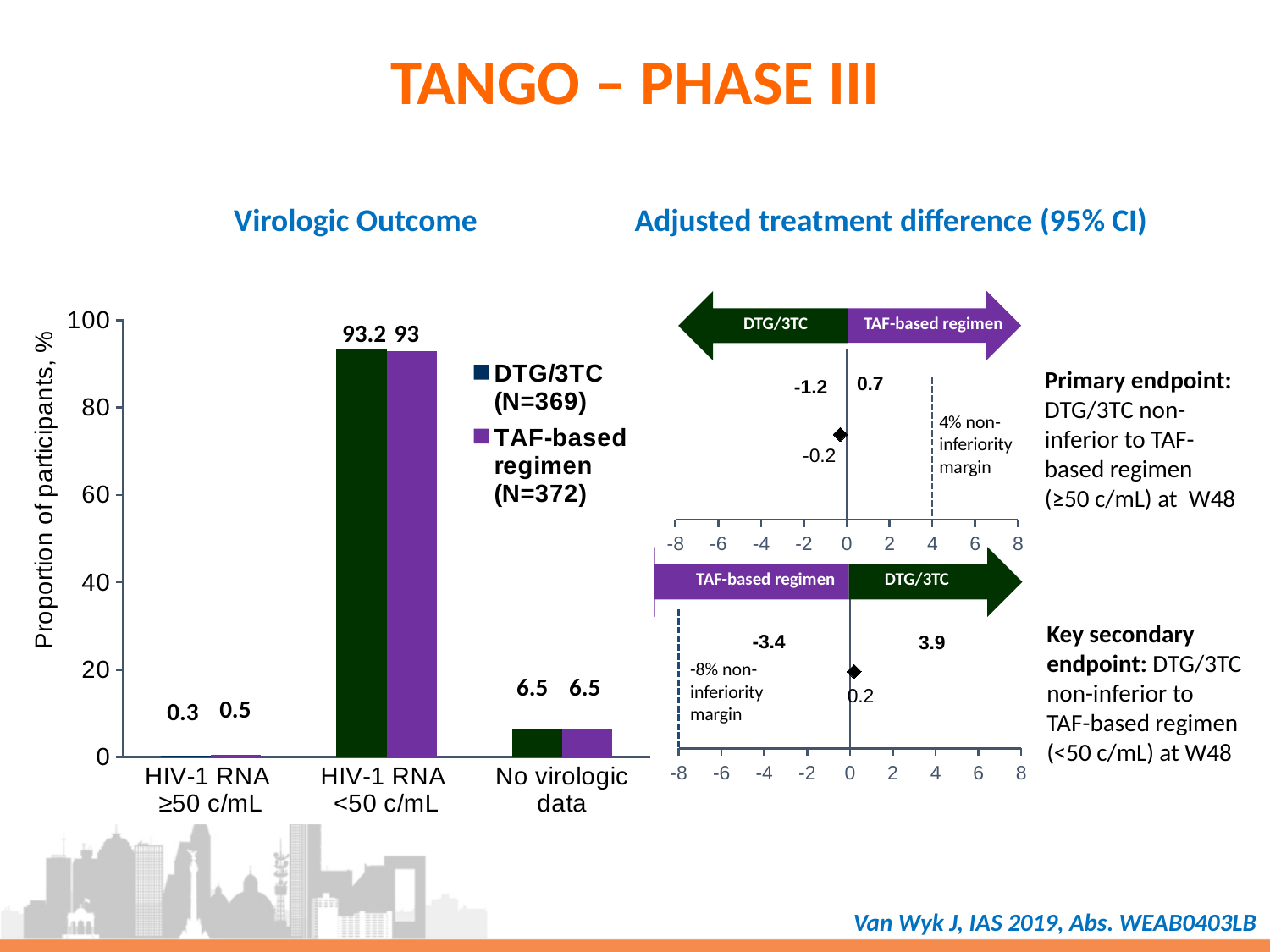
In the Virologic Outcome chart, which is larger in the HIV-1 RNA ≥50 c/mL category: DTG/3TC or the TAF-based regimen? TAF-based regimen In the Virologic Outcome chart, what is the value for the TAF-based regimen in the HIV-1 RNA ≥50 c/mL category? 0.5 In the Virologic Outcome chart, what is the difference between the DTG/3TC and TAF-based regimen values in the HIV-1 RNA <50 c/mL category? 0.2 In the Virologic Outcome chart, what is the value for the TAF-based regimen in the No virologic data category? 6.5 What kind of chart is the Virologic Outcome chart? bar chart In the Adjusted treatment difference chart for the primary endpoint, what is the point estimate of the treatment difference? -0.2 In the Virologic Outcome chart, how many series does the legend list? 2 In the Adjusted treatment difference chart for the key secondary endpoint, what is the upper limit of the 95% CI? 3.9 In the Virologic Outcome chart, which category has the lowest value for the TAF-based regimen? HIV-1 RNA ≥50 c/mL In the Virologic Outcome chart, which category has the highest value for DTG/3TC? HIV-1 RNA <50 c/mL In the Virologic Outcome chart, what is the value for DTG/3TC in the HIV-1 RNA <50 c/mL category? 93.2 In the Virologic Outcome chart, how many categories are shown on the x axis? 3